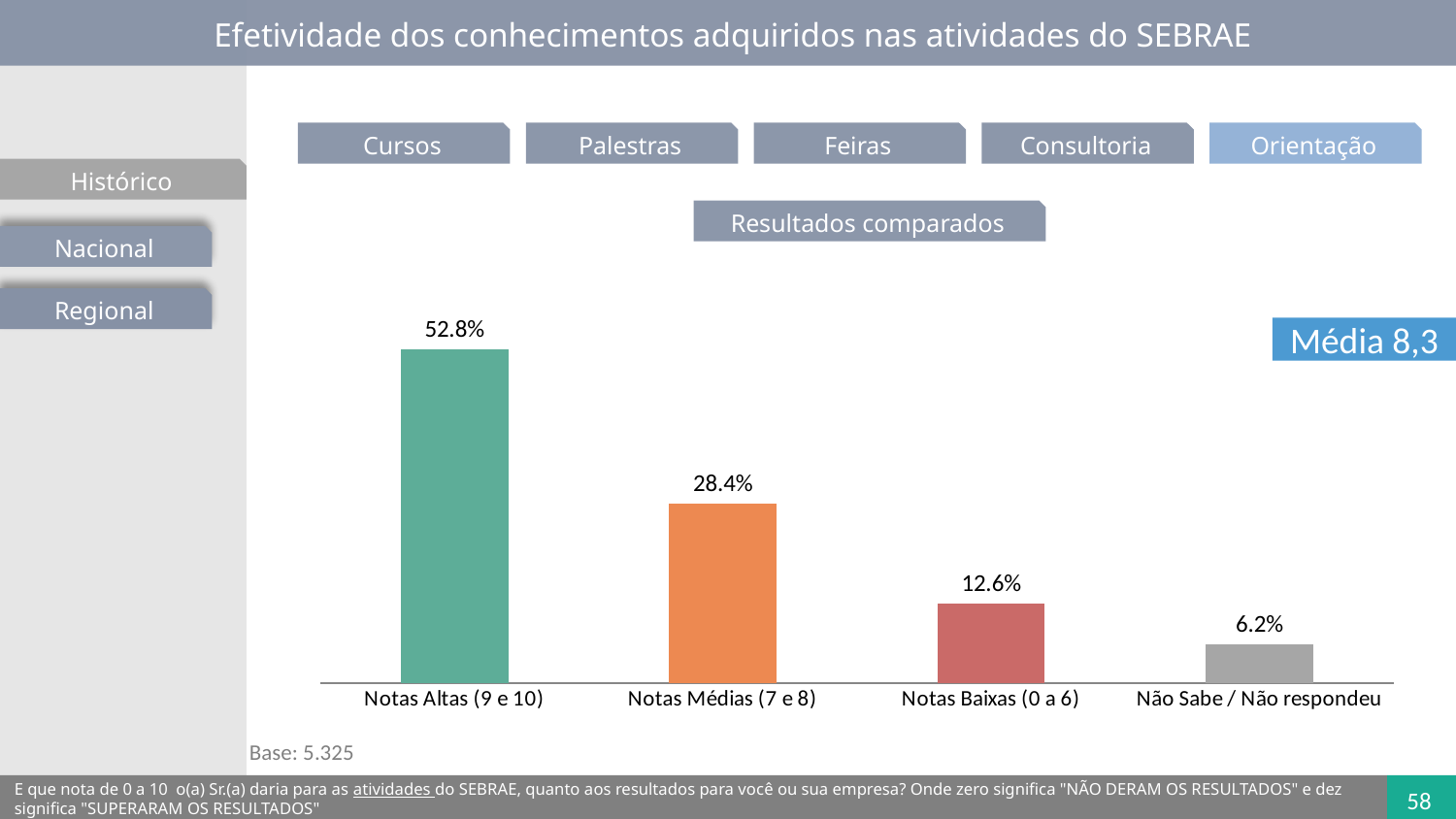
What is the value for Notas Médias (7 e 8)? 28.4% What is the value for Notas Baixas (0 a 6)? 12.6% Which category has the highest value? Notas Altas (9 e 10) What average (Média) is shown on the slide? 8,3 What kind of chart is shown on the slide? Bar chart How many categories are shown in the chart? 4 Which category has the lowest value? Não Sabe / Não respondeu Which is larger, the value for Notas Baixas (0 a 6) or Não Sabe / Não respondeu? Notas Baixas (0 a 6) What is the value for Notas Altas (9 e 10)? 52.8% What is the value for Não Sabe / Não respondeu? 6.2% What is the difference between the values for Notas Altas (9 e 10) and Notas Médias (7 e 8)? 24.4% Do the values rise or fall from left to right across the categories? Fall